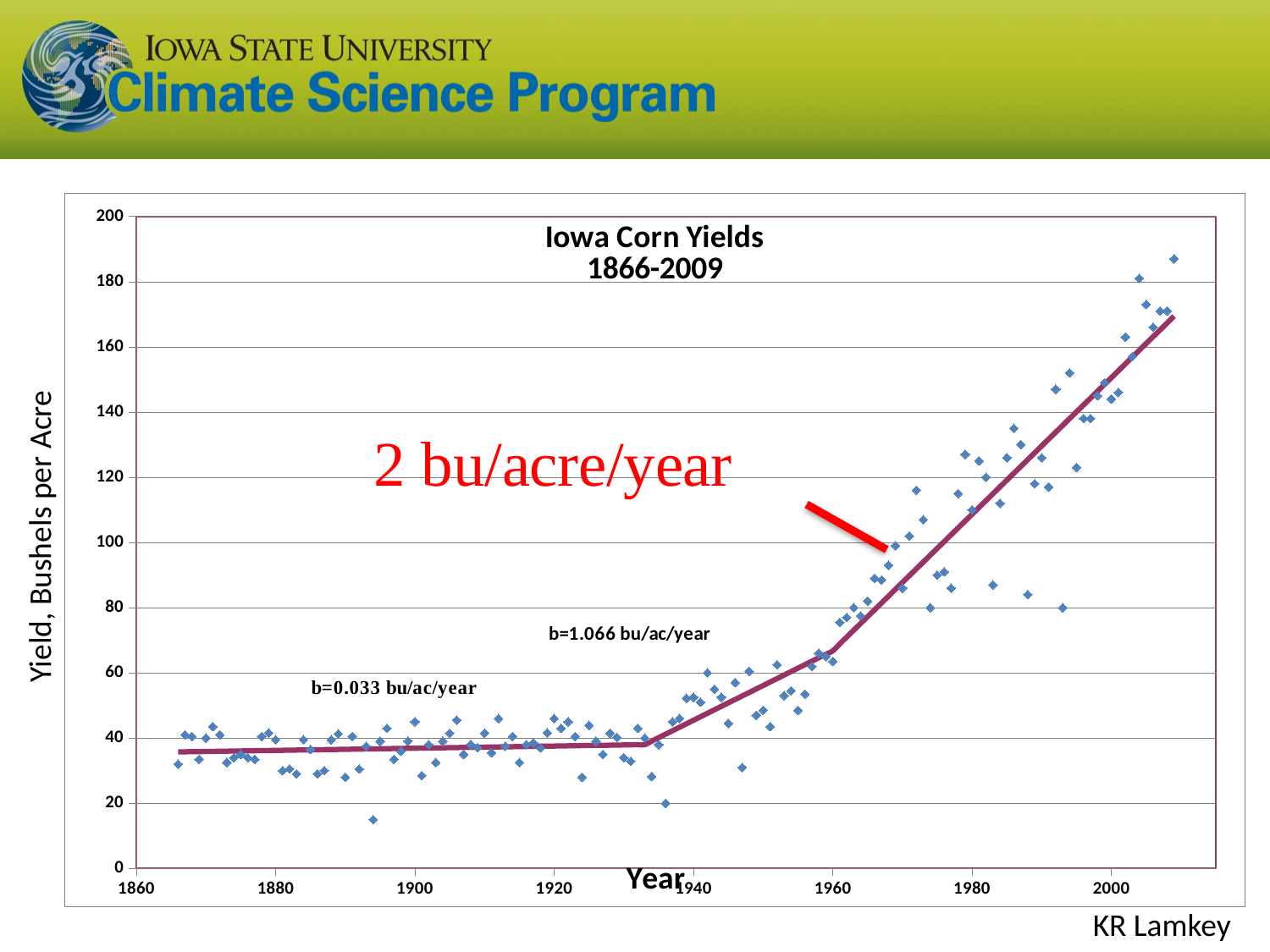
Is the highest plotted yield, near 2009, greater or less than 180? greater Do corn yields generally rise or fall from 1960 to 2009? rise What slope is printed for the early, flat segment of the trend line? b=0.033 bu/ac/year What is the label of the vertical axis? Yield, Bushels per Acre Which period has higher yields: around 1880 or around 2000? around 2000 What slope is printed for the middle segment of the trend line? b=1.066 bu/ac/year What is the title of the chart? Iowa Corn Yields 1866-2009 Are the plotted yields between 1866 and 1930 greater or less than 60? less Is the lowest plotted yield, near 1894, greater or less than 20? less What rate is printed in large red text for the steepest segment of the trend line? 2 bu/acre/year What is the highest value shown on the vertical axis? 200 What kind of chart is shown on the slide? scatter chart